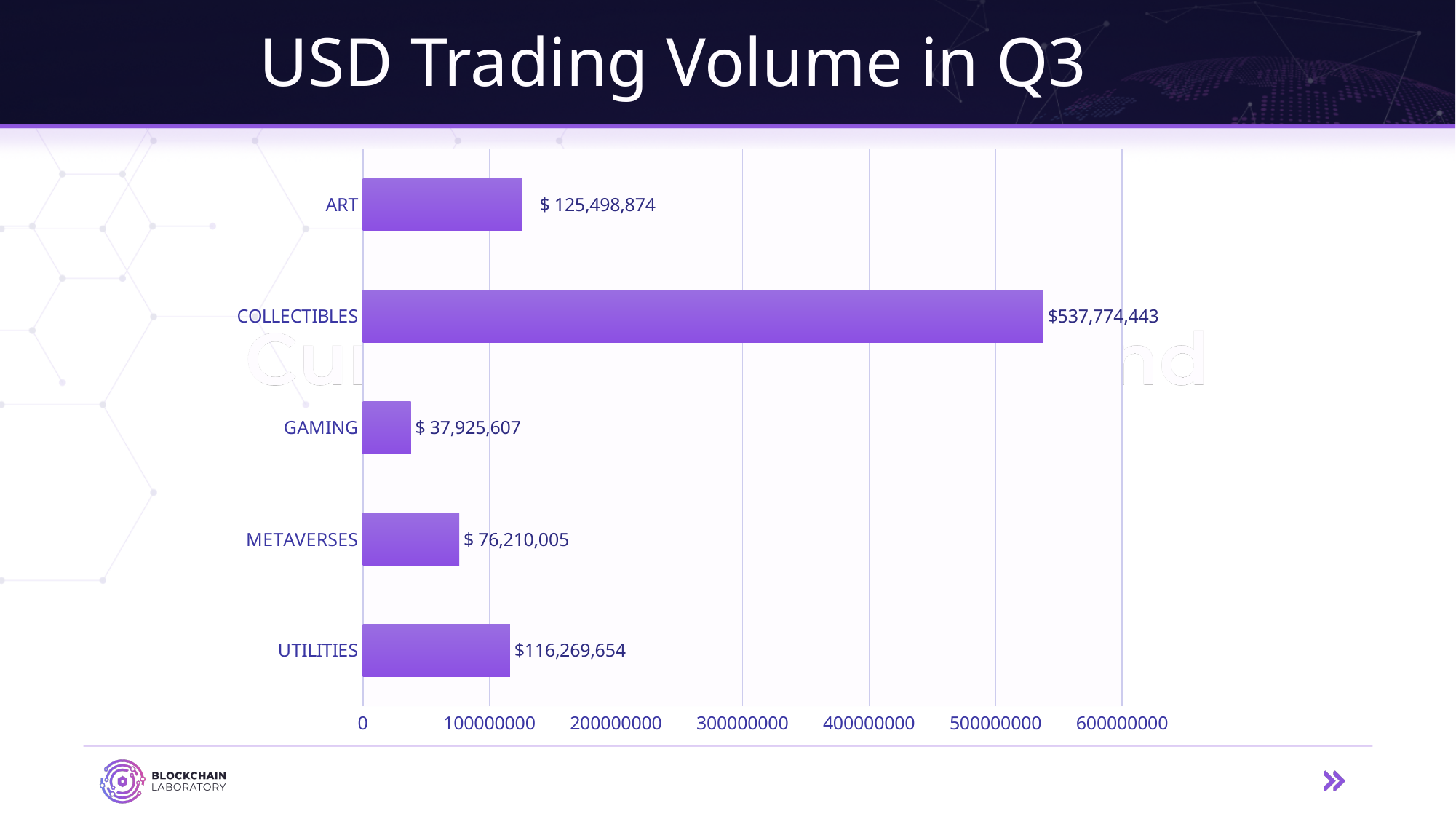
What is the USD trading volume for UTILITIES? $116,269,654 Is the value for COLLECTIBLES greater or less than 500000000? greater What is the USD trading volume for COLLECTIBLES? $537,774,443 Which category has the lowest USD trading volume? GAMING What is the difference between the trading volume of METAVERSES and GAMING? $38,284,398 Which category has the highest USD trading volume? COLLECTIBLES What is the difference between the trading volume of COLLECTIBLES and ART? $412,275,569 What is the USD trading volume for METAVERSES? $ 76,210,005 What type of chart is shown on the slide? Bar chart What is the USD trading volume for GAMING? $ 37,925,607 Which has a larger trading volume, ART or UTILITIES? ART How many categories are shown in the chart? 5